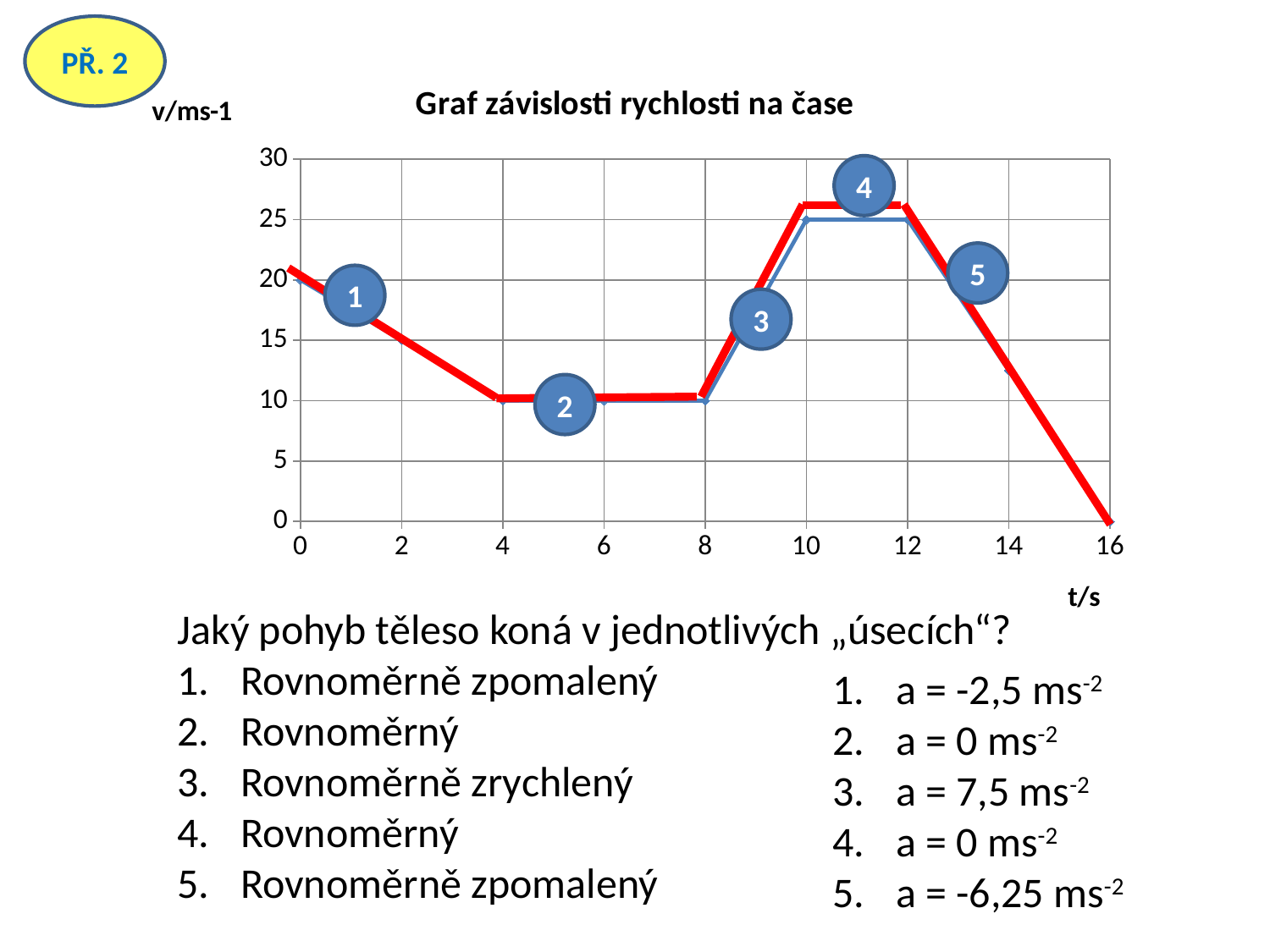
What kind of chart is shown on the slide? line chart Does the velocity rise or fall between t = 0 s and t = 4 s? fall What is the velocity v at t = 0 s? 20 What is the velocity v at t = 4 s? 10 At what time does the velocity reach its lowest value? 16 What is the title of the chart? Graf závislosti rychlosti na čase How many numbered segments (circles) are marked on the chart? 5 What is the velocity v at t = 10 s? 25 Is the velocity at t = 14 s greater or less than 20? less What is the velocity v at t = 16 s? 0 What is the difference between the velocity at t = 10 s and the velocity at t = 4 s? 15 What is the highest velocity value reached on the chart? 25